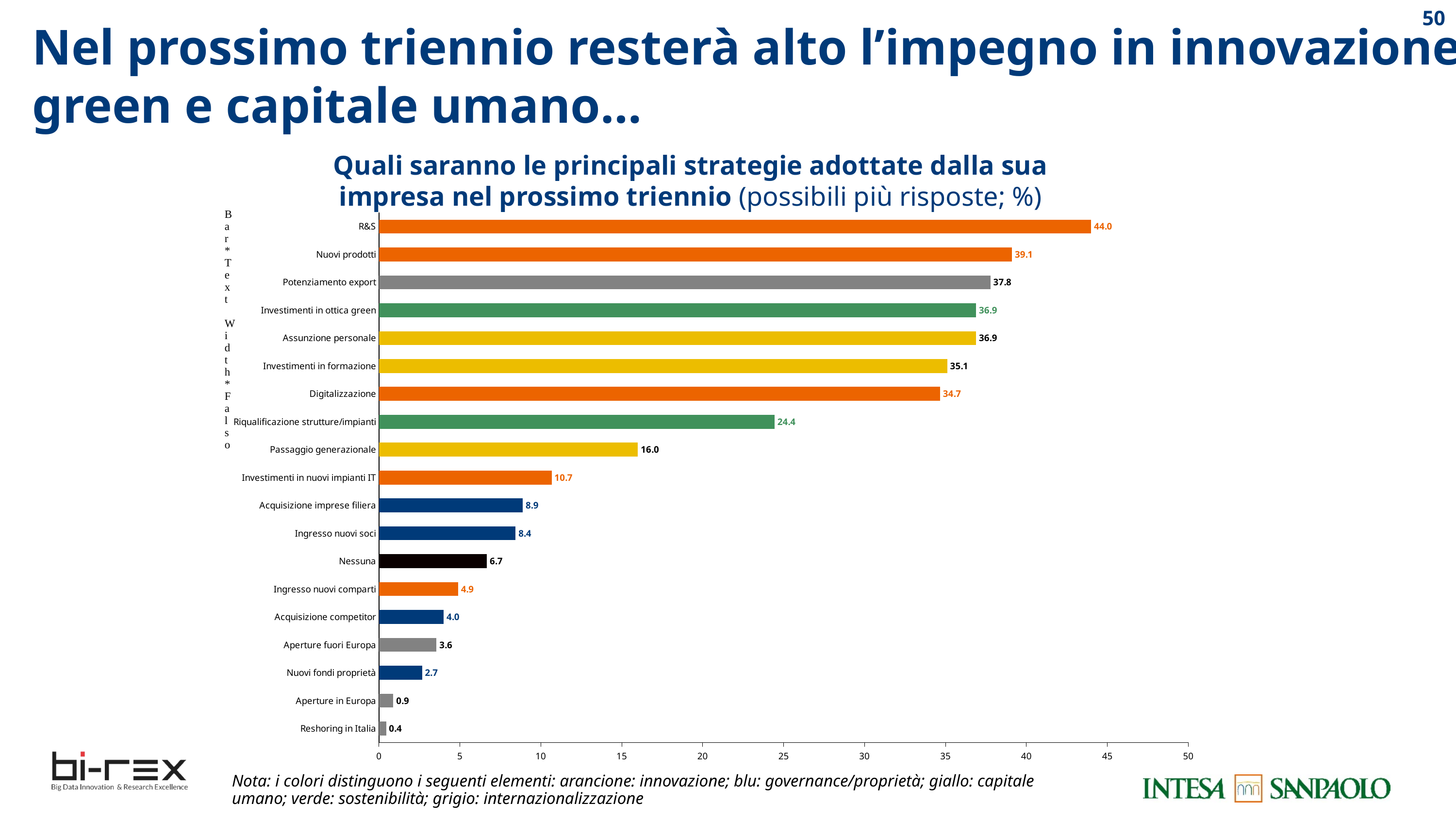
What is the value for Nessuna? 6.7 How many categories are shown in the chart? 19 What kind of chart is shown on the slide? bar chart What is the value for Potenziamento export? 37.8 According to the note, what do the green bars represent? sostenibilità Which category has the lowest value? Reshoring in Italia What is the value for R&S? 44.0 What is the difference between the values for Acquisizione imprese filiera and Ingresso nuovi soci? 0.5 Which category has the highest value? R&S What is the value for Riqualificazione strutture/impianti? 24.4 Which is larger, the value for Digitalizzazione or the value for Passaggio generazionale? Digitalizzazione What is the difference between the values for R&S and Nuovi prodotti? 4.9